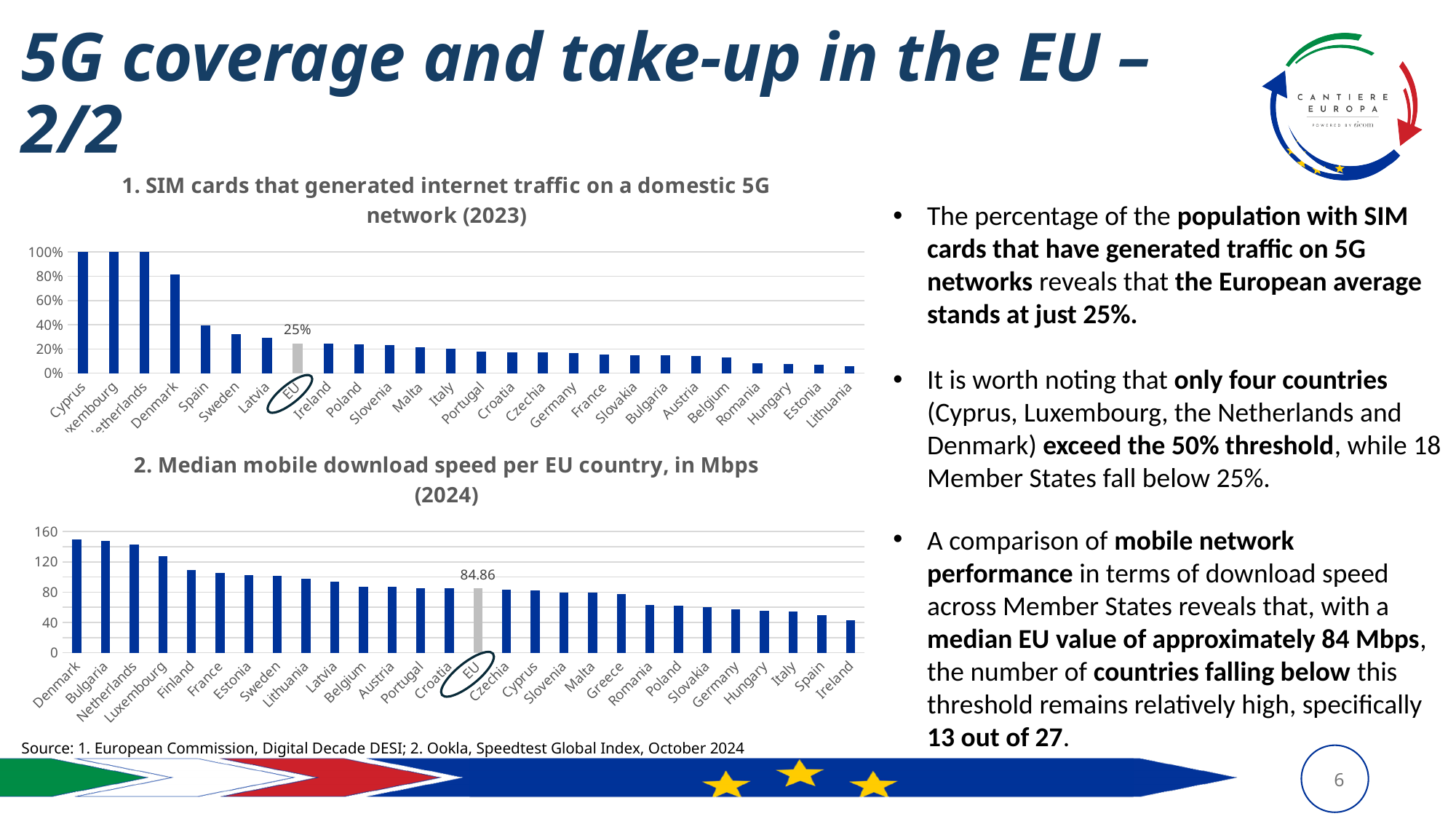
In the chart '1. SIM cards that generated internet traffic on a domestic 5G network (2023)', which has the larger value, Spain or Hungary? Spain What type of chart is the chart '2. Median mobile download speed per EU country, in Mbps (2024)'? Bar chart In the chart '2. Median mobile download speed per EU country, in Mbps (2024)', what is the value shown for the EU? 84.86 In the chart '1. SIM cards that generated internet traffic on a domestic 5G network (2023)', what is the value shown for the EU? 25% In the chart '1. SIM cards that generated internet traffic on a domestic 5G network (2023)', which country has the lowest value? Lithuania In the chart '2. Median mobile download speed per EU country, in Mbps (2024)', which country has the lowest median download speed? Ireland In the chart '2. Median mobile download speed per EU country, in Mbps (2024)', is the value for Denmark greater or less than 120? greater In the chart '2. Median mobile download speed per EU country, in Mbps (2024)', which has the larger value, Finland or Spain? Finland In the chart '1. SIM cards that generated internet traffic on a domestic 5G network (2023)', is the value for Denmark greater or less than 60%? greater In the chart '2. Median mobile download speed per EU country, in Mbps (2024)', which country has the highest median download speed? Denmark In the chart '2. Median mobile download speed per EU country, in Mbps (2024)', is the value for Ireland greater or less than 80? less